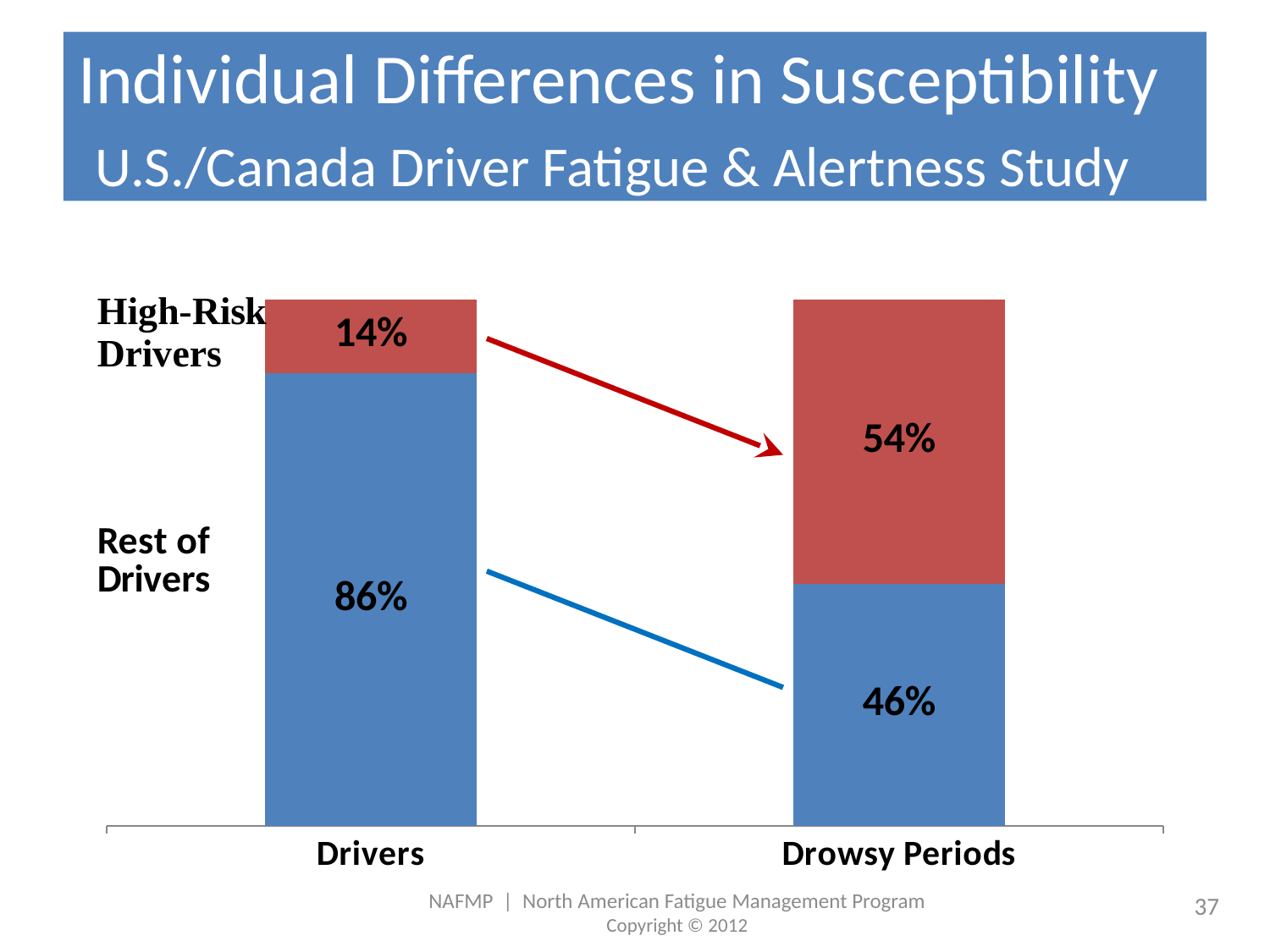
Which colour represents High-Risk Drivers in the chart? Red Which is larger in the Drowsy Periods bar: High-Risk Drivers or Rest of Drivers? High-Risk Drivers Which category has the higher High-Risk Drivers share: Drivers or Drowsy Periods? Drowsy Periods What kind of chart is shown on the slide? Stacked bar chart What percentage of Drivers are Rest of Drivers? 86% What is the total of the Drivers stacked bar? 100% How many categories are shown on the x axis? 2 What share of Drowsy Periods is attributed to Rest of Drivers? 46% What percentage of Drivers are High-Risk Drivers? 14% What is the difference between the High-Risk Drivers share in Drowsy Periods and in Drivers? 40% What share of Drowsy Periods is attributed to High-Risk Drivers? 54% What is the difference between the Rest of Drivers share and the High-Risk Drivers share in the Drivers bar? 72%